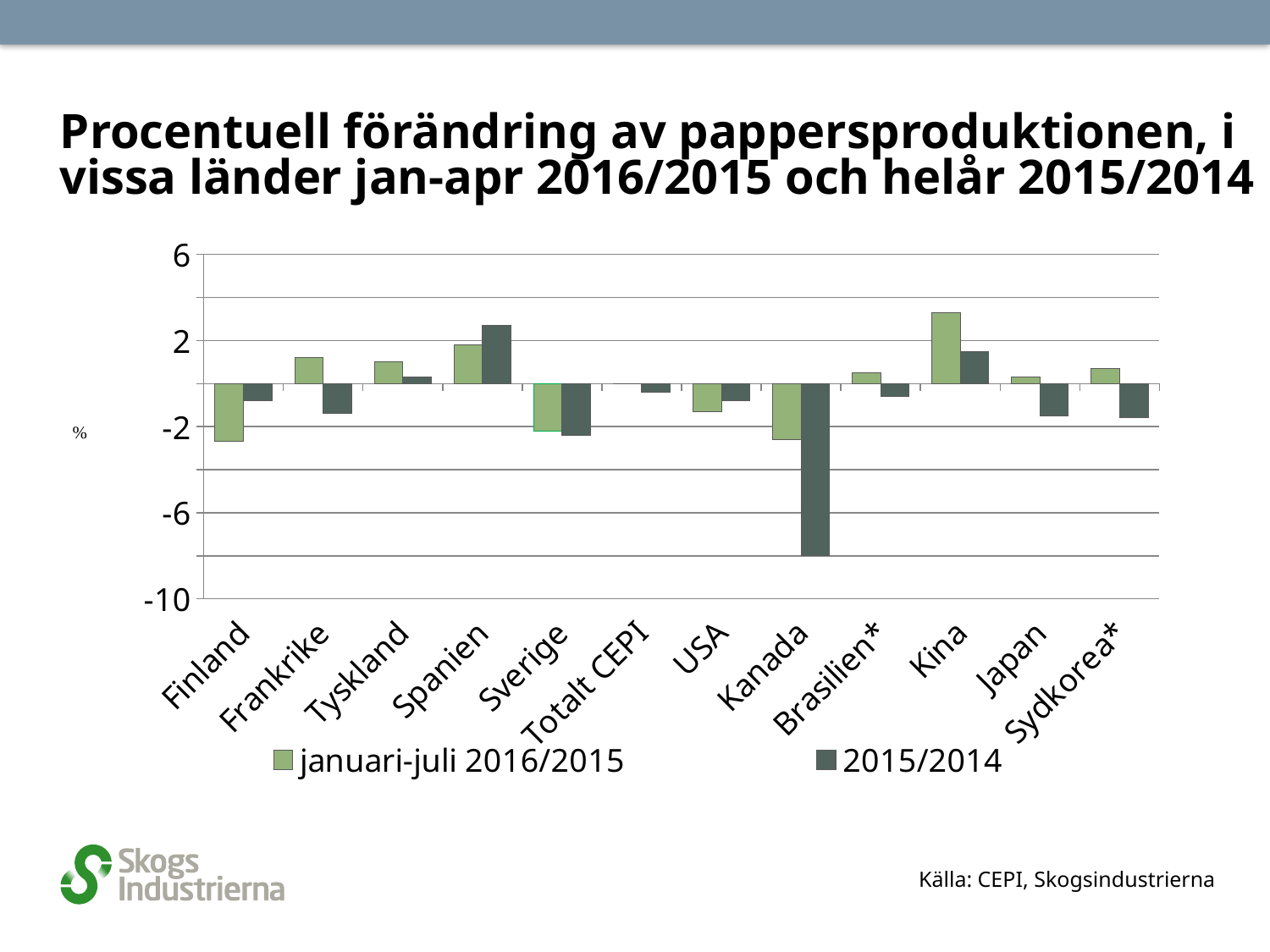
Is the januari-juli 2016/2015 value for Kina greater or less than 2? greater Which category has the lowest value for the 2015/2014 series? Kanada Which category has the highest value for the januari-juli 2016/2015 series? Kina Which category has the highest value for the 2015/2014 series? Spanien Is the 2015/2014 value for Kanada greater or less than -6? less What source is cited for the chart at the bottom of the slide? CEPI, Skogsindustrierna For the 2015/2014 series, which is larger: the value for Spanien or the value for Kina? Spanien How many countries/categories are shown on the x axis of the chart? 12 How many series does the chart's legend list? 2 What are the two series named in the chart's legend? januari-juli 2016/2015 and 2015/2014 What kind of chart is shown on the slide? bar chart Is the januari-juli 2016/2015 value for Finland greater or less than -2? less